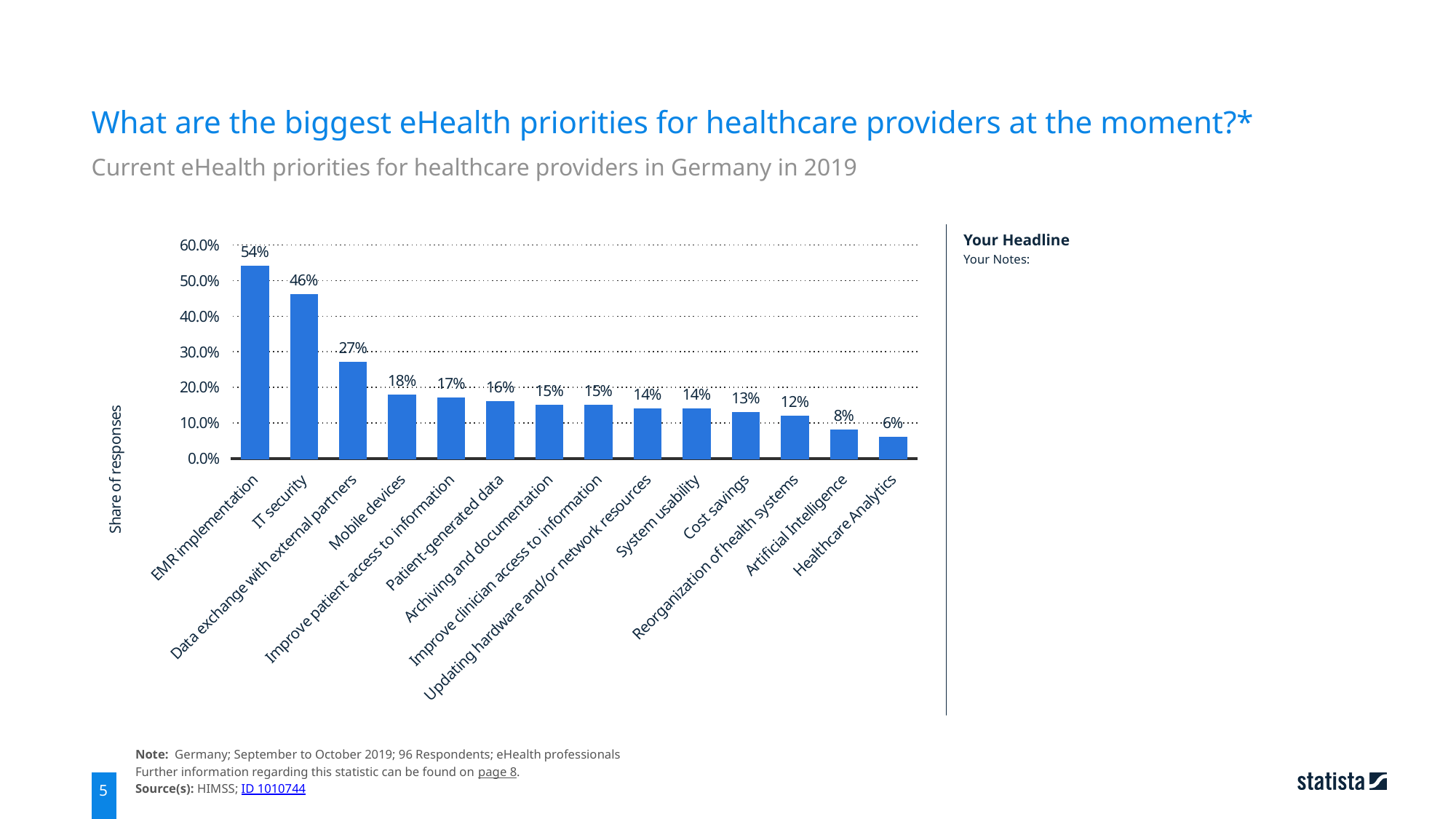
Which category has the lowest value? Healthcare Analytics How many categories are shown in the chart? 14 Which is larger, the value for Mobile devices or the value for Cost savings? Mobile devices Is the value for IT security greater or less than 40.0%? greater What is the value for Data exchange with external partners? 27% What kind of chart is shown on the slide? bar chart What is the label of the vertical axis? Share of responses Do the values rise or fall from left to right along the x axis? fall What is the difference between the values for EMR implementation and IT security? 8% What is the value for Artificial Intelligence? 8% Which category has the highest value? EMR implementation What is the value for EMR implementation? 54%